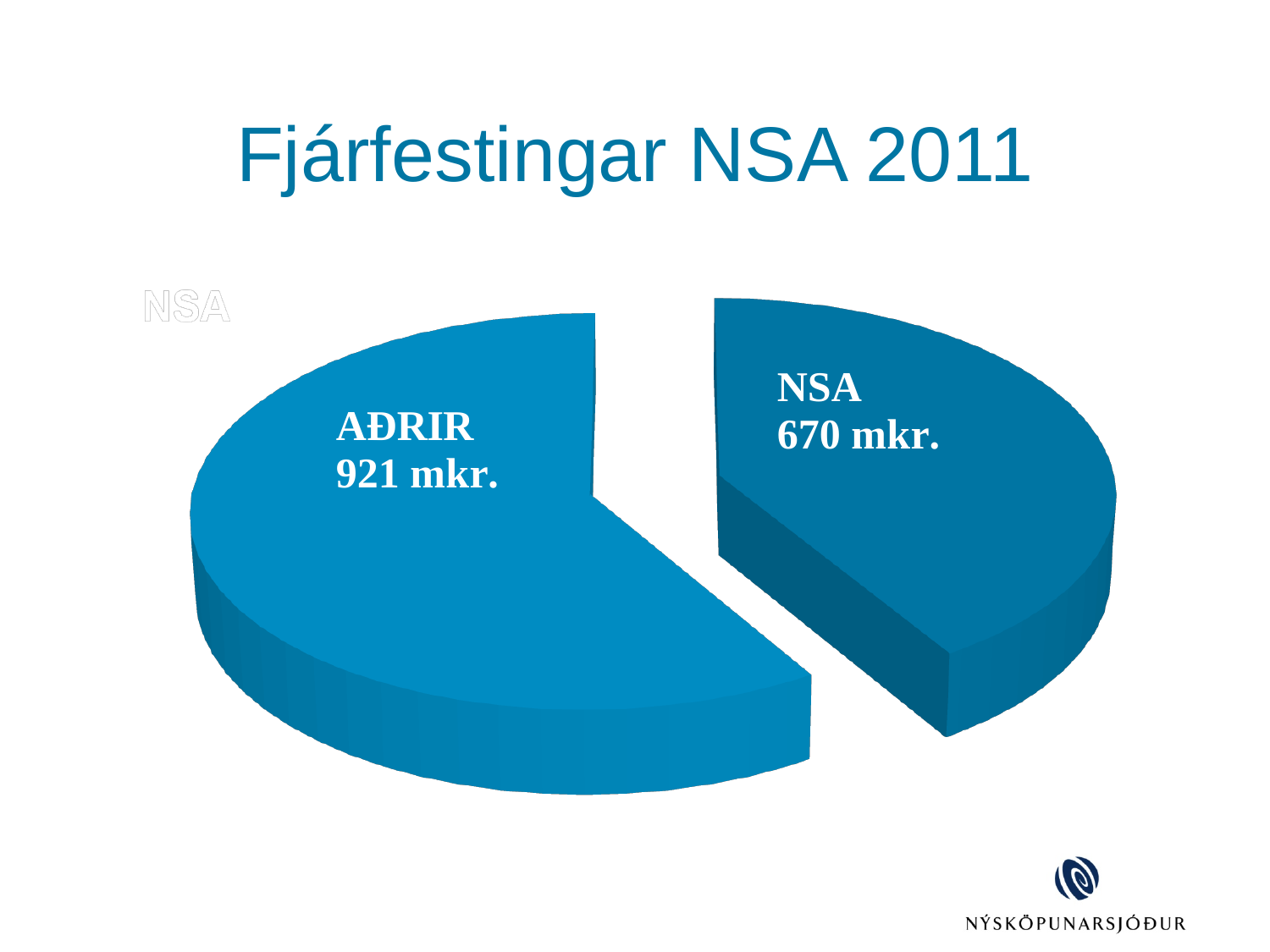
Which slice is pulled out (exploded) from the rest of the pie? NSA What kind of chart is shown on the slide? Pie chart What is the difference between the AÐRIR value and the NSA value? 251 mkr. Which is larger, the NSA slice or the AÐRIR slice? AÐRIR What share of the total does the NSA slice represent? 42.1% What is the value shown for the AÐRIR slice? 921 mkr. What is the value shown for the NSA slice? 670 mkr. Which slice of the pie chart is the smallest? NSA How many slices does the pie chart have? 2 What is the total of the two slices in the pie chart? 1591 mkr. What is the title of the chart on the slide? Fjárfestingar NSA 2011 Which slice of the pie chart is the largest? AÐRIR